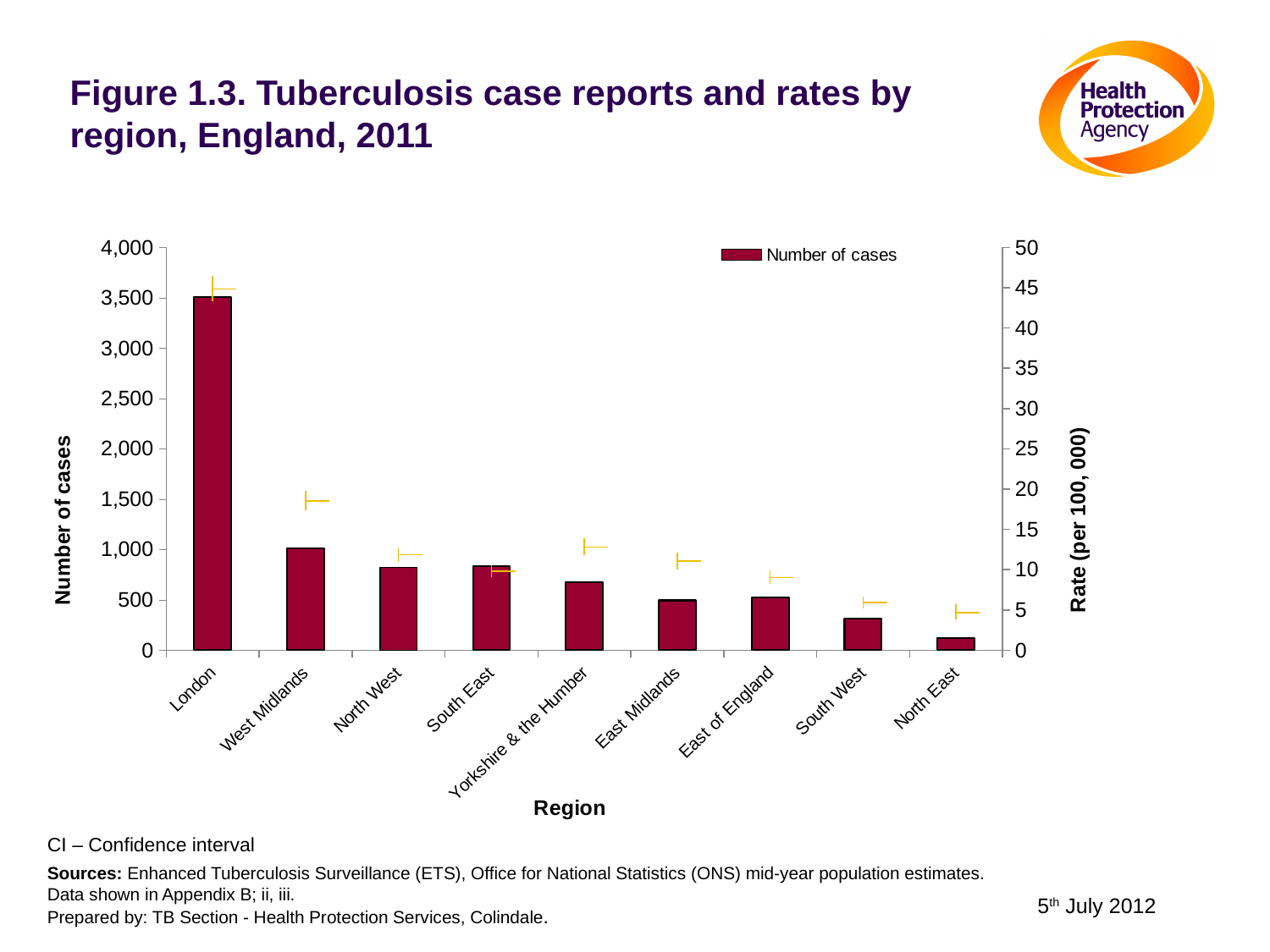
Which region has more cases, London or West Midlands? London Which region has more cases, South West or North East? South West Is the number of cases for Yorkshire & the Humber greater or less than 1,000? less How many series does the chart legend list? 1 Which region has the lowest number of cases? North East How many regions are shown on the x axis of the chart? 9 What kind of chart is shown on the slide? Bar chart Is the number of cases for London greater or less than 3,000? greater What is the label of the left vertical axis? Number of cases Which region has the highest number of cases? London Is the number of cases for North East greater or less than 500? less